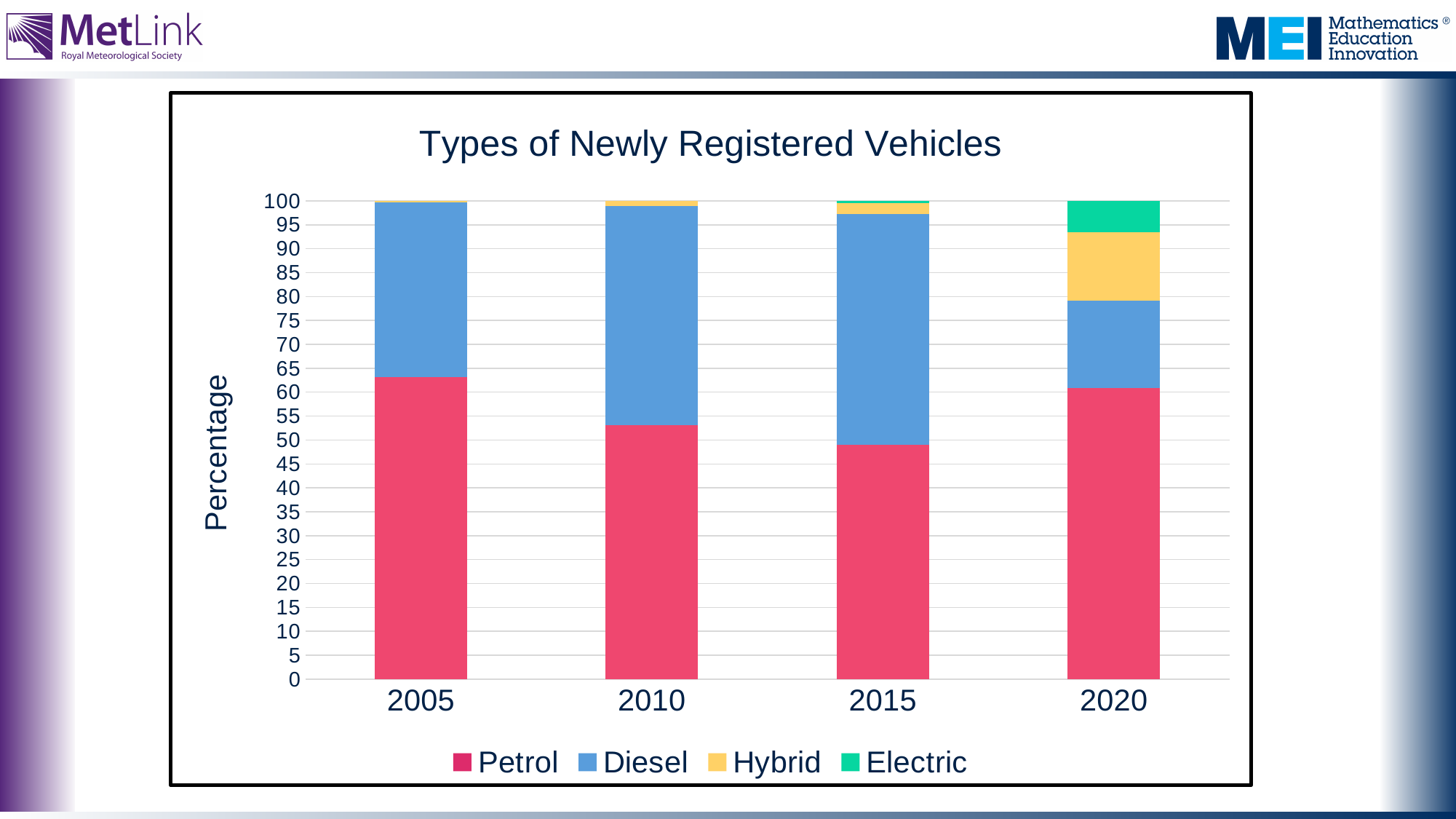
Is the Petrol share in 2005 greater or less than 60? greater How many series does the legend list? 4 Does the Petrol share rise or fall from 2005 to 2015? Fall In which year is the Petrol share the lowest? 2015 How many years are shown on the x axis? 4 What is the title of the chart? Types of Newly Registered Vehicles Which is larger in 2020, the Hybrid share or the Electric share? Hybrid In which year is the Diesel share the smallest? 2020 Is the Petrol share in 2010 greater or less than 50? greater What is the label on the vertical axis? Percentage In which year is the Petrol share the highest? 2005 What kind of chart is shown on the slide? Stacked bar chart